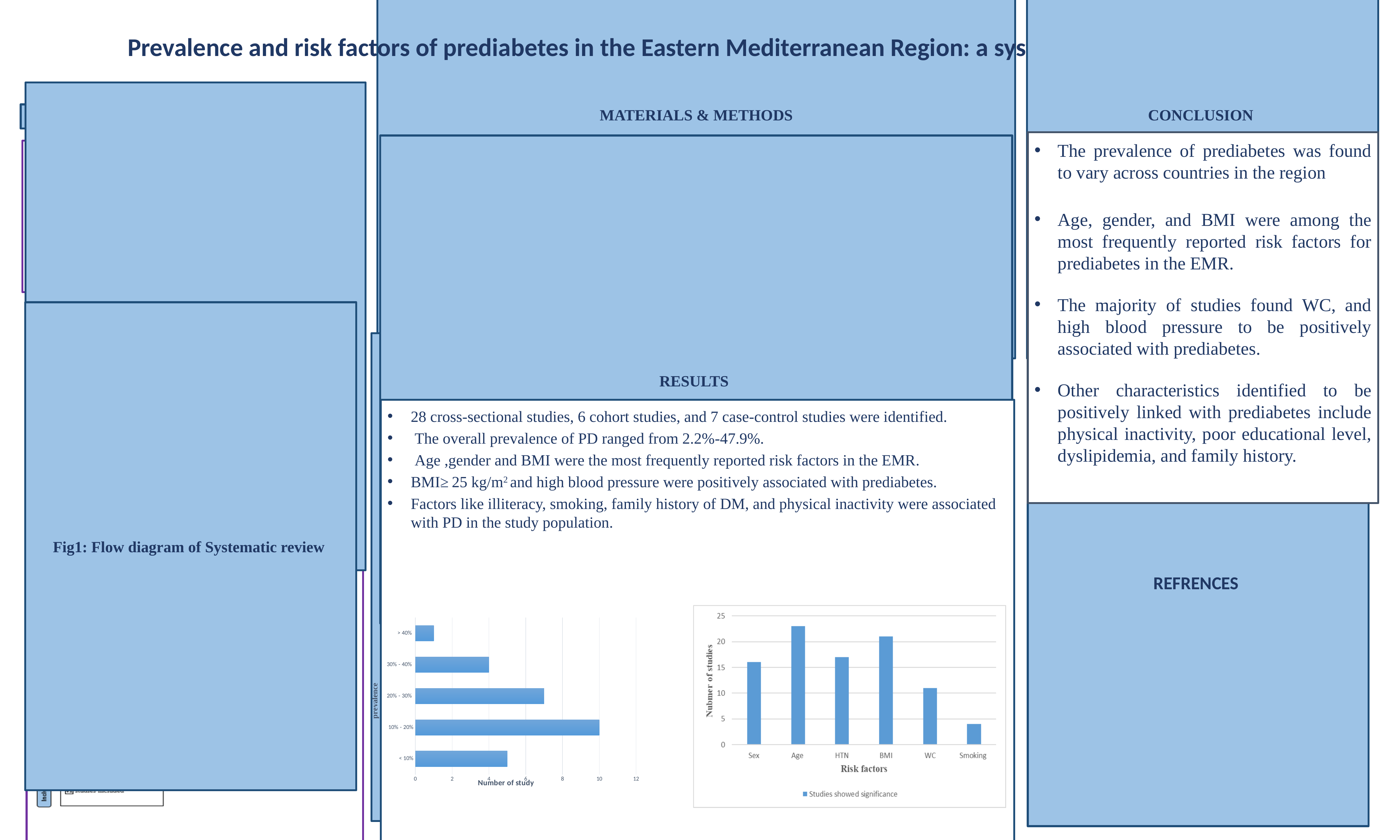
In the left chart, which prevalence category has the highest number of studies? 10% - 20% What kind of chart is the left chart (prevalence vs number of study)? bar chart What is the x-axis title of the left chart? Number of study How many prevalence categories are shown in the left chart? 5 In the left chart, is the value for 20% - 30% greater or less than 6? greater In the left chart, which prevalence category has the lowest number of studies? > 40% In the right chart (Risk factors), which risk factor has the lowest number of studies? Smoking How many risk factors are shown in the right chart? 6 What is the legend entry of the right chart? Studies showed significance In the right chart (Risk factors), which risk factor has the highest number of studies? Age In the right chart, is the value for Smoking greater or less than 5? less In the right chart, which has more studies, BMI or HTN? BMI